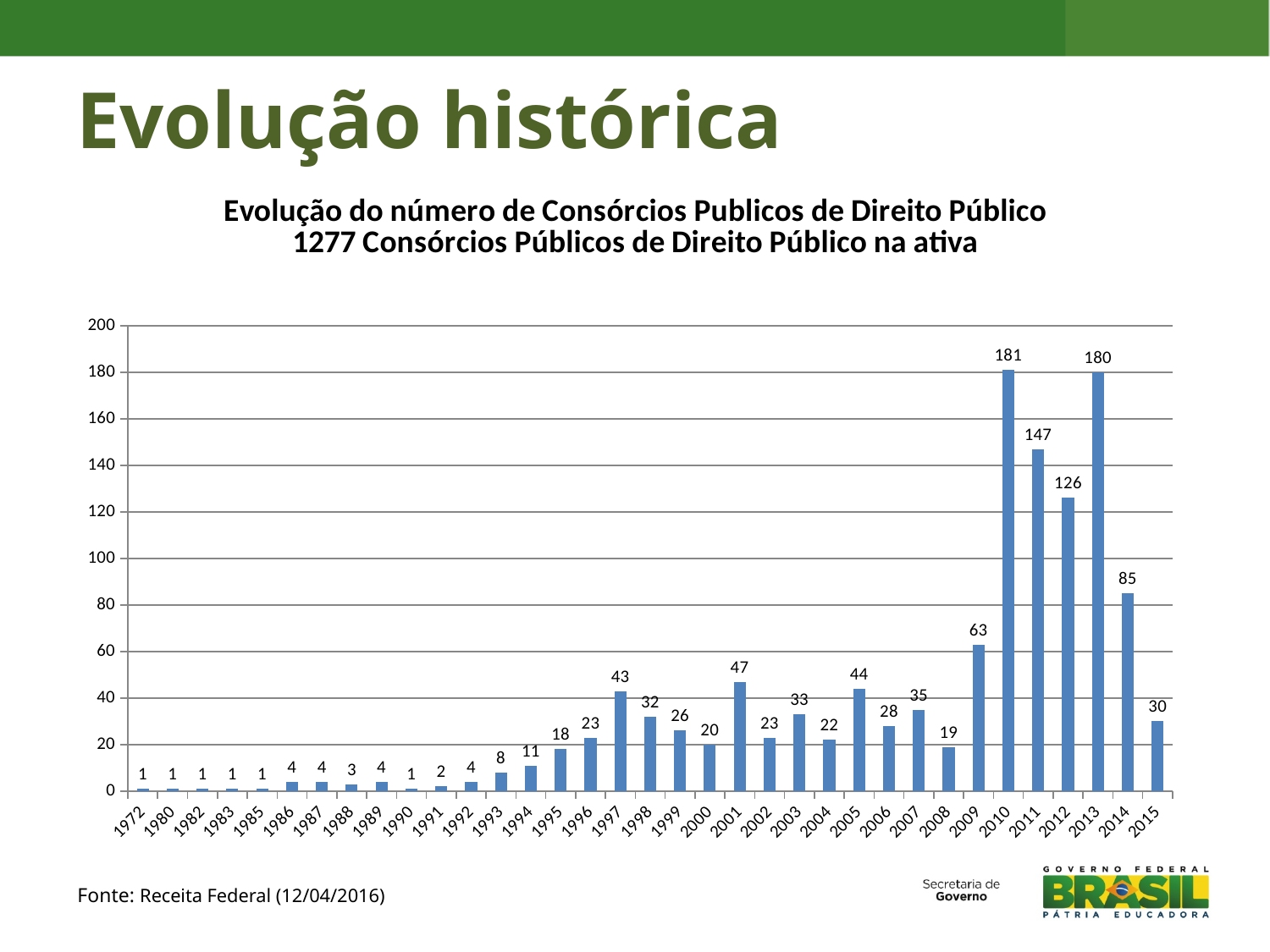
Is the value for 2009 greater or less than 60? greater Which year has the highest value? 2010 What is the value for 2014? 85 What is the difference between the values for 2011 and 2012? 21 Which is larger, the value for 2001 or the value for 2005? 2001 How many years are shown on the x axis? 35 What kind of chart is shown on the slide? bar chart What is the value for 1997? 43 What is the difference between the values for 2010 and 2013? 1 Do the values rise or fall from 2010 to 2012? fall What is the value for 2010? 181 What is the source cited below the chart? Receita Federal (12/04/2016)